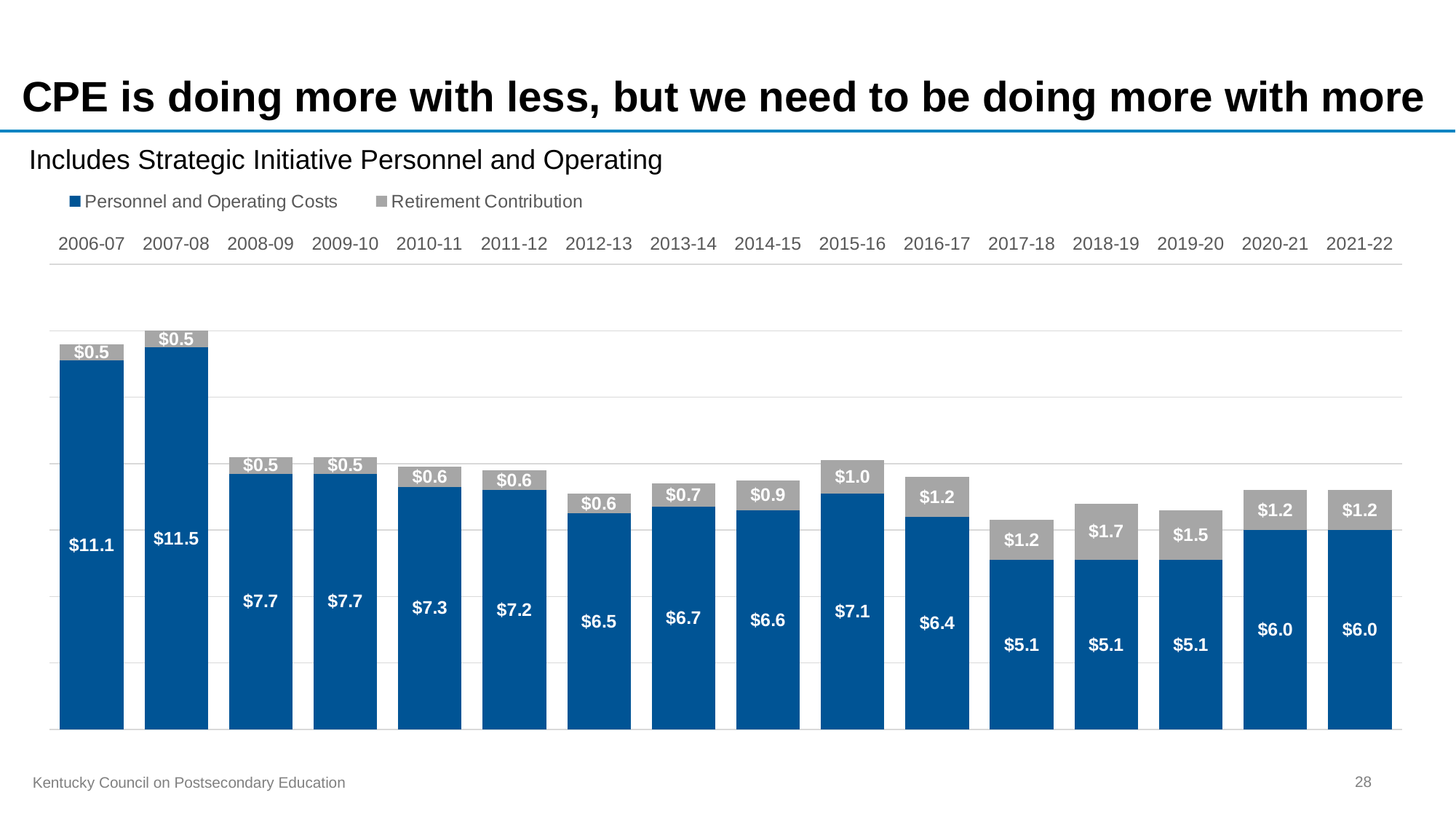
What kind of chart is shown on the slide? Stacked bar chart How many series does the legend list? 2 What is the difference in Personnel and Operating Costs between 2007-08 and 2021-22? $5.5 Which year has the highest Personnel and Operating Costs? 2007-08 What is the total of the stacked bar for 2007-08? $12.0 What is the Personnel and Operating Costs value for 2015-16? $7.1 Which is larger, the Retirement Contribution for 2019-20 or for 2020-21? 2019-20 What is the total of the stacked bar for 2018-19? $6.8 What is the Retirement Contribution value for 2018-19? $1.7 How many fiscal years are shown on the x axis? 16 What is the Personnel and Operating Costs value for 2007-08? $11.5 Which year has the highest Retirement Contribution? 2018-19